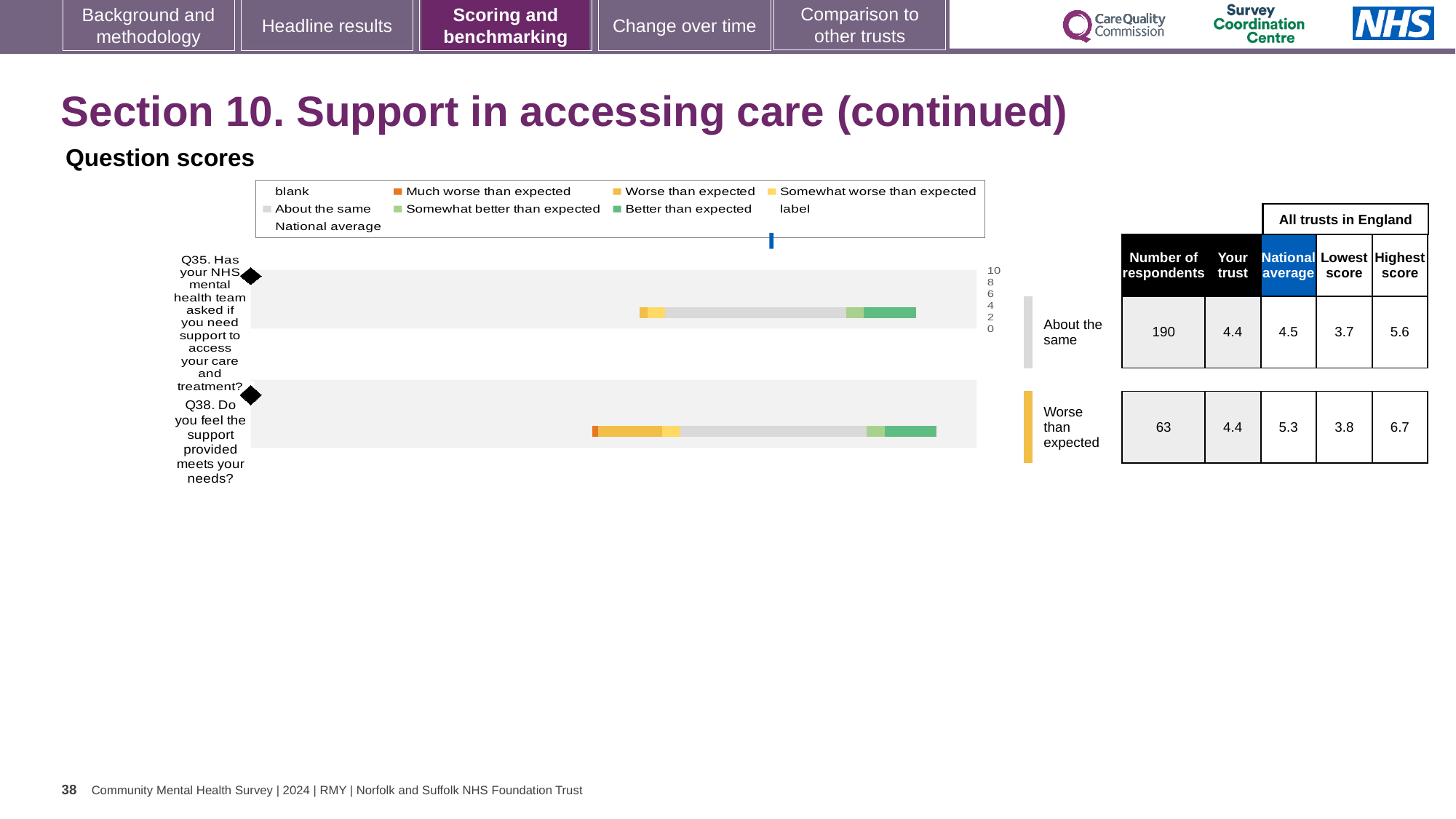
What is the difference between the national average and the 'Your trust' score for Q38? 0.9 Which question has more respondents, Q35 or Q38? Q35 How many questions are plotted in the question scores chart? 2 What is the national average score for Q38? 5.3 What benchmark category is Q38 rated as? Worse than expected What is the lowest score across all trusts in England for Q35? 3.7 What kind of chart is used to show the question scores? bar chart How many respondents answered Q38 (Do you feel the support provided meets your needs?)? 63 How many respondents answered Q35 (Has your NHS mental health team asked if you need support to access your care and treatment?)? 190 What is the 'Your trust' score for Q35? 4.4 Which question has the higher national average score, Q35 or Q38? Q38 What is the highest score across all trusts in England for Q38? 6.7